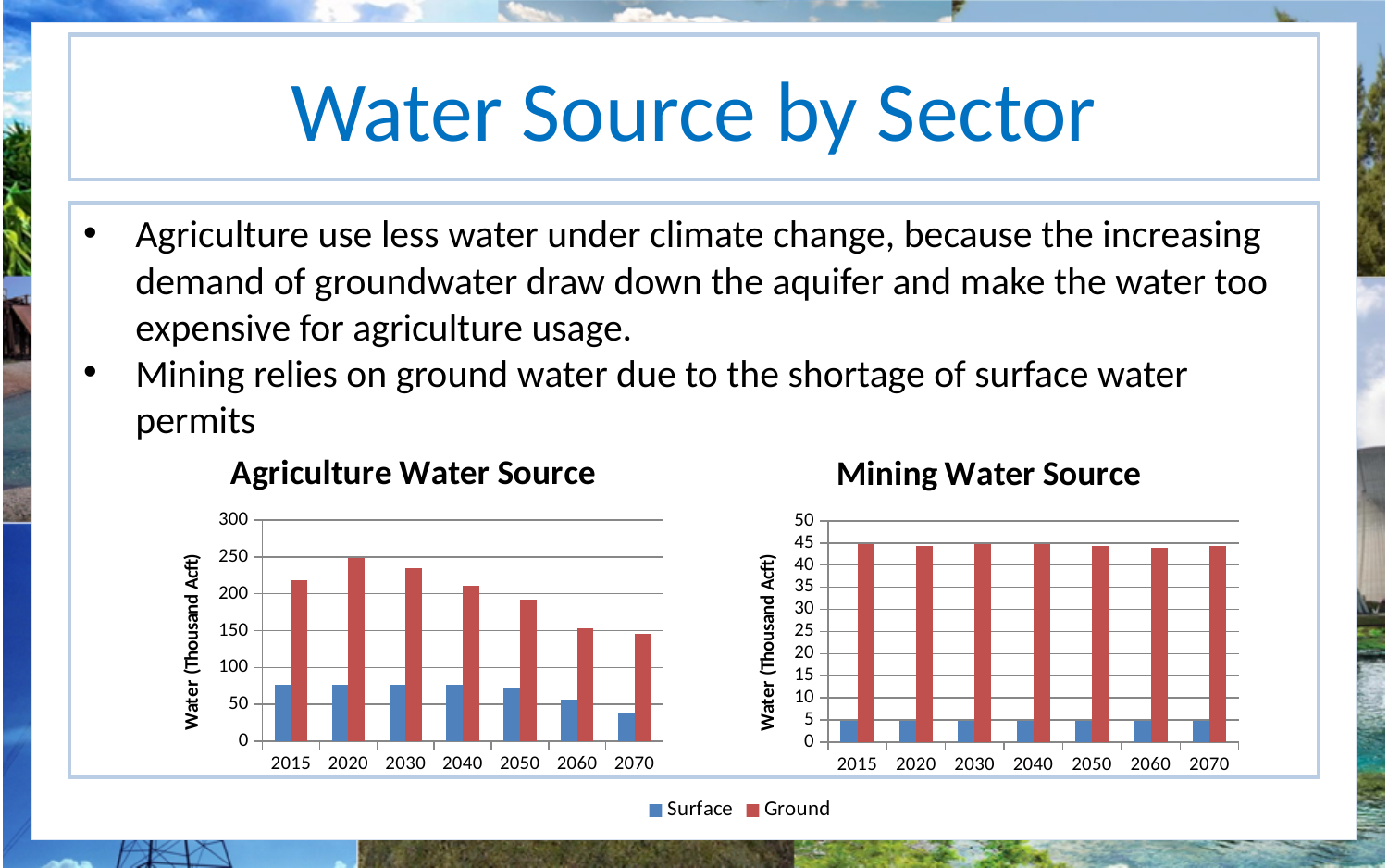
In the Agriculture Water Source chart, which year has the lowest Surface value? 2070 What is the y-axis title of the Mining Water Source chart? Water (Thousand Acft) In the Agriculture Water Source chart, which is larger, the Ground value for 2020 or the Ground value for 2060? 2020 In the Mining Water Source chart, is the Surface value for 2050 greater or less than 10? less In the Mining Water Source chart, is the Ground value for 2030 greater or less than 40? greater How many series does the legend list for the charts? 2 In the Agriculture Water Source chart, is the Ground value for 2015 greater or less than 200? greater What kind of chart is the Agriculture Water Source chart? bar chart How many years are shown on the x axis of the Mining Water Source chart? 7 In the Agriculture Water Source chart, which year has the highest Ground value? 2020 In the Agriculture Water Source chart, do the Ground values rise or fall from 2020 to 2070? fall